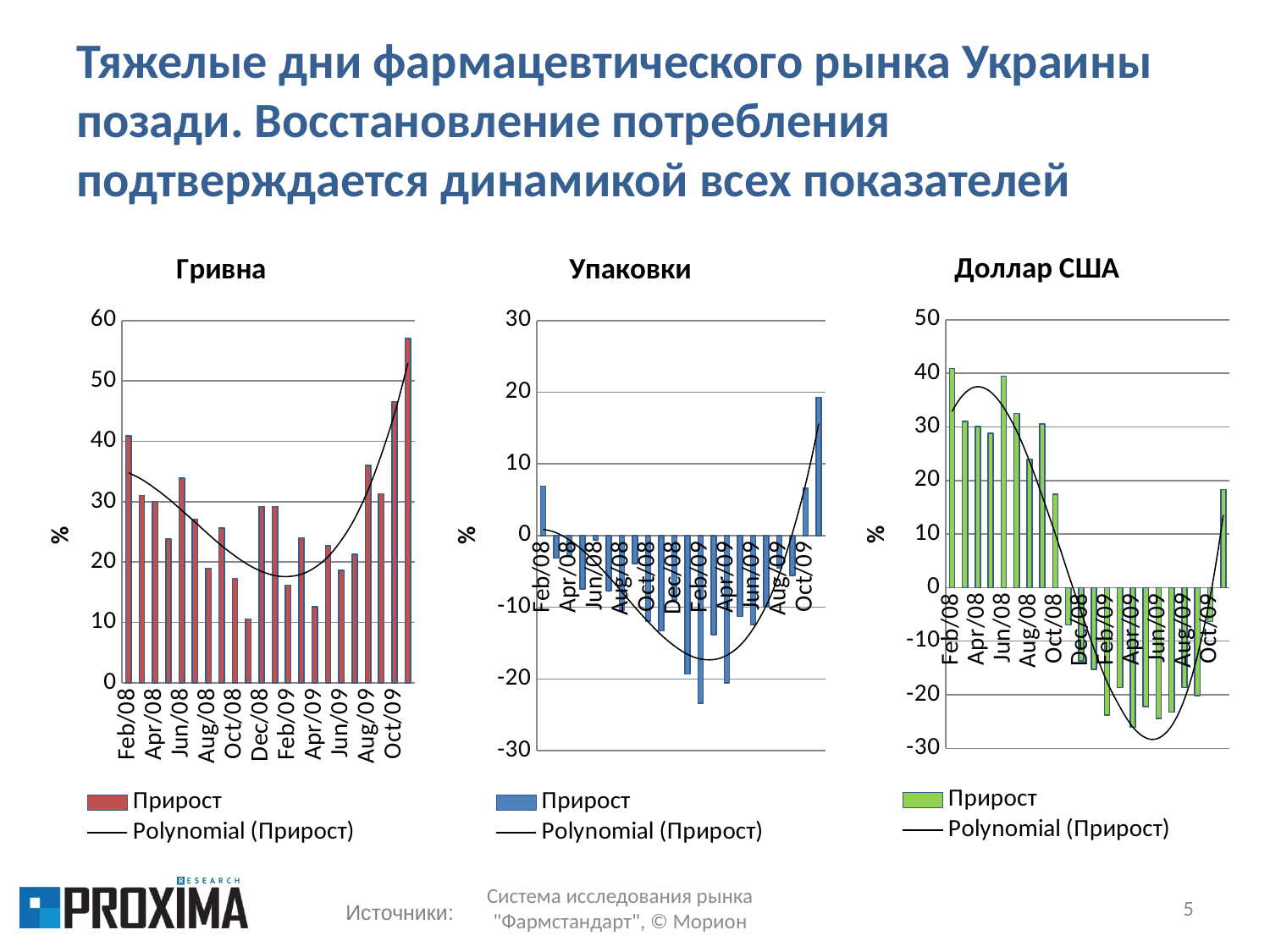
In the Доллар США chart, is the value for Apr/09 greater or less than -20? less In the Гривна chart, is the value for Feb/08 greater or less than 30? greater How many entries does the legend of the Упаковки chart list? 2 In the Упаковки chart, is the value for Oct/09 greater or less than 0? greater In the Гривна chart, which labeled month has the highest value? Oct/09 In the Доллар США chart, which labeled month has the highest value? Feb/08 In the Доллар США chart, do the values rise or fall from Feb/08 to Apr/09? fall What colour are the bars in the Доллар США chart? green What kind of chart is the Гривна chart? bar chart In the Упаковки chart, which is larger, the value for Feb/08 or the value for Apr/08? Feb/08